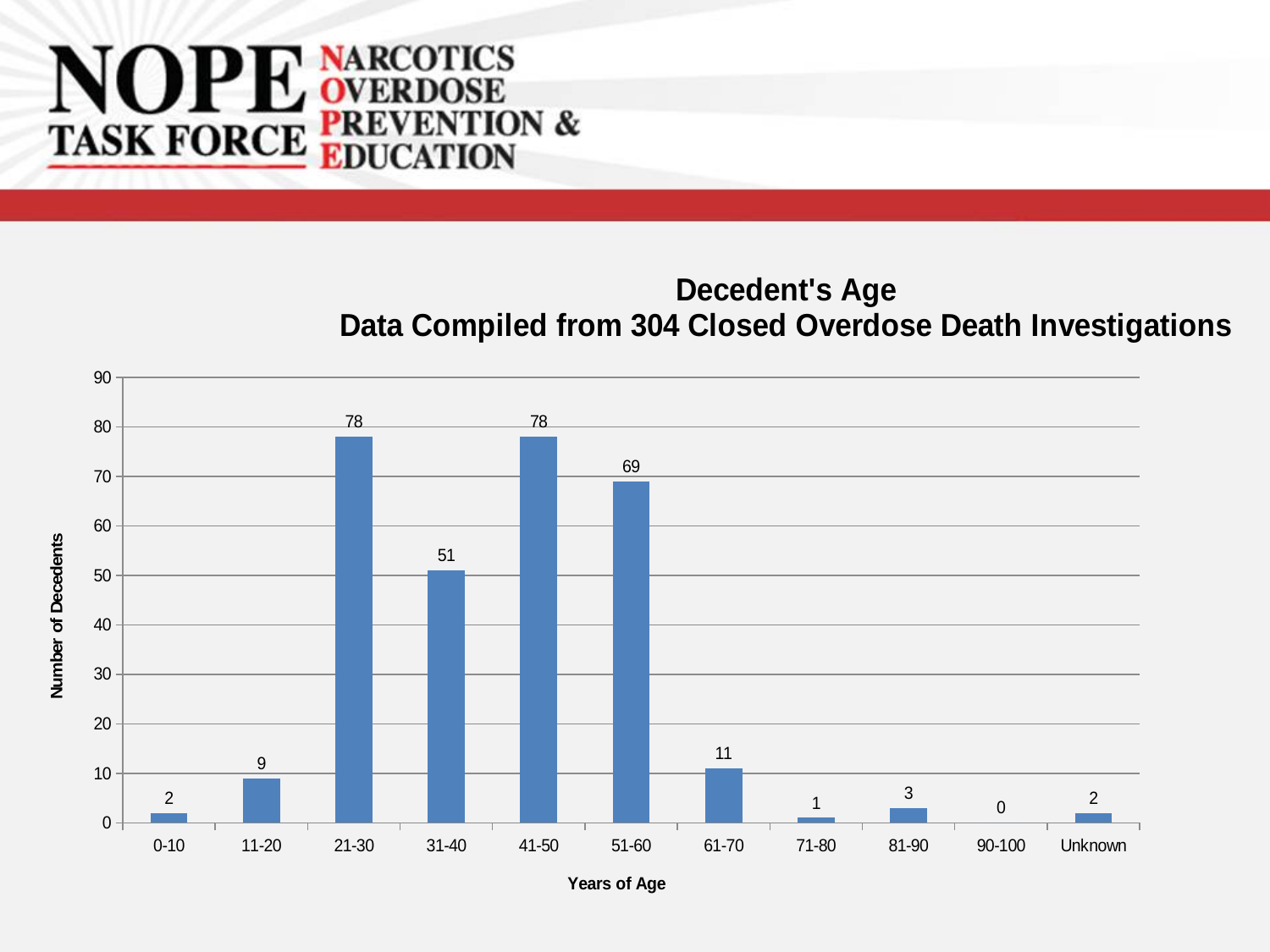
What is the number of decedents in the 51-60 age group? 69 What is the number of decedents in the 31-40 age group? 51 How many age categories are shown on the x axis? 11 Which age group has the lowest number of decedents? 90-100 What kind of chart is shown on the slide? Bar chart What is the label of the y axis? Number of Decedents Which age group has more decedents, 11-20 or 61-70? 61-70 What is the difference in the number of decedents between the 41-50 and 51-60 age groups? 9 What is the number of decedents in the 21-30 age group? 78 What is the number of decedents in the 90-100 age group? 0 What is the number of decedents with an Unknown age? 2 What is the difference in the number of decedents between the 21-30 and 31-40 age groups? 27